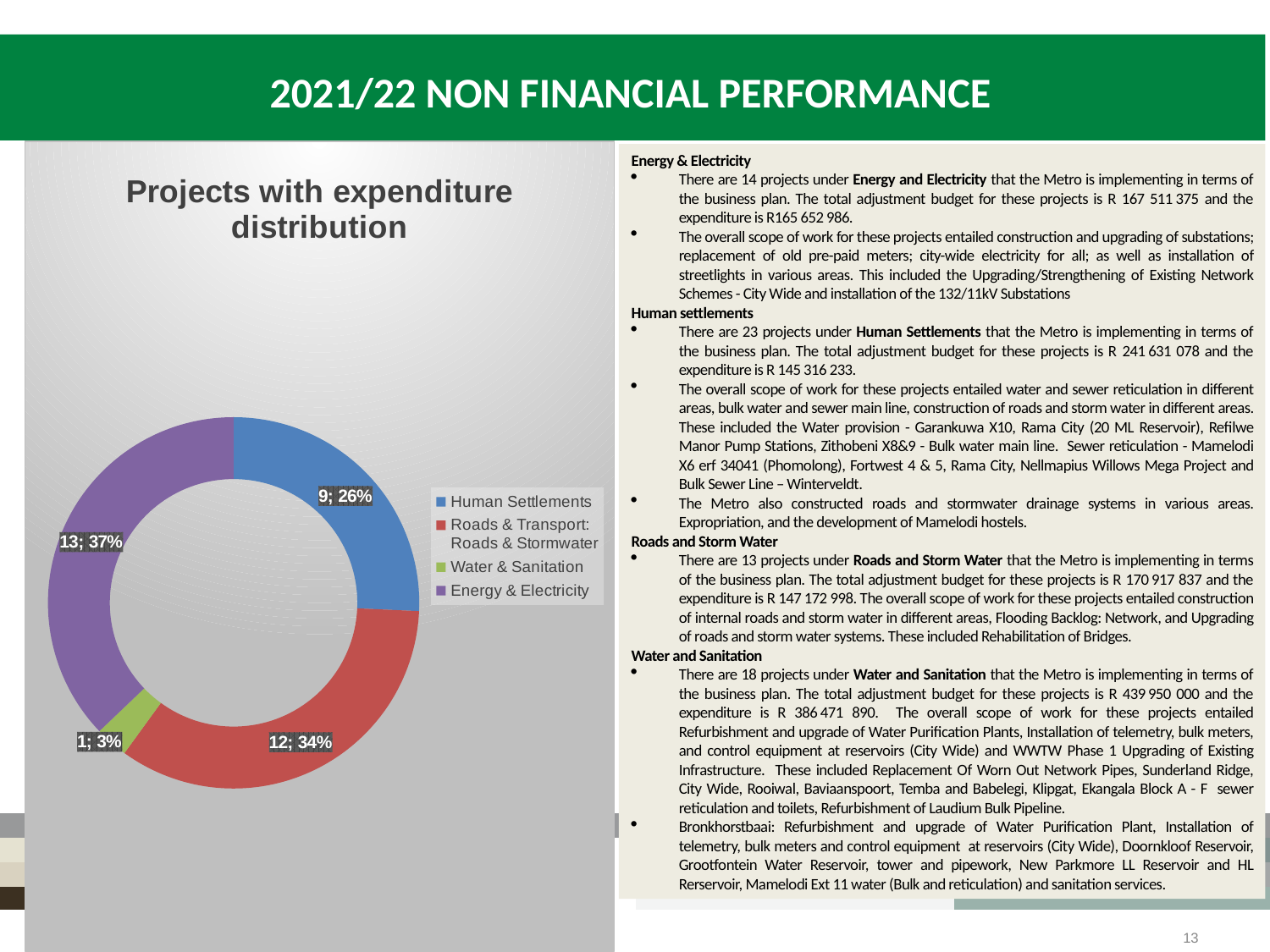
What percentage share does the Water & Sanitation slice show? 3% What percentage share does the Energy & Electricity slice show? 37% What kind of chart is shown under the title "Projects with expenditure distribution"? Doughnut (pie) chart How many categories does the legend of the chart list? 4 What is the title of the chart on the left of the slide? Projects with expenditure distribution Which category has the largest slice in the chart? Energy & Electricity What is the difference in percentage points between the Energy & Electricity share and the Human Settlements share? 11 percentage points What number of projects is labelled on the Energy & Electricity slice? 13 What percentage share does the Human Settlements slice show? 26% Which slice is larger: Human Settlements or Roads & Transport: Roads & Stormwater? Roads & Transport: Roads & Stormwater What number of projects is labelled on the Roads & Transport: Roads & Stormwater slice? 12 Which category has the smallest slice in the chart? Water & Sanitation